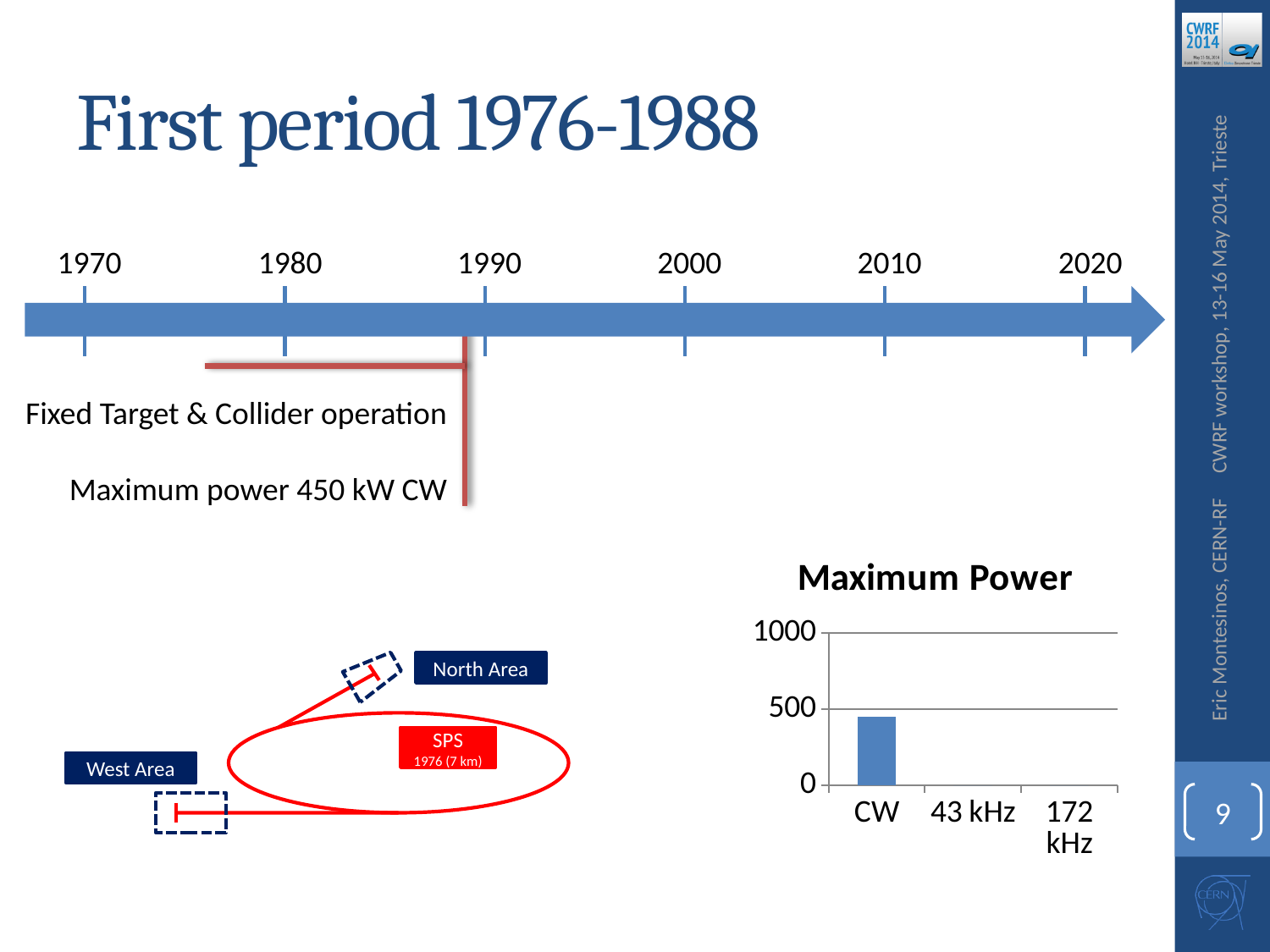
In the Maximum Power chart, which is larger, the value for CW or the value for 43 kHz? CW In the Maximum Power chart, which is larger, the value for CW or the value for 172 kHz? CW What kind of chart is the Maximum Power chart? bar chart How many categories are shown on the x axis of the Maximum Power chart? 3 What is the highest tick value shown on the y axis of the Maximum Power chart? 1000 What is the title of the chart on the slide? Maximum Power In the Maximum Power chart, is the value for CW greater or less than 500? less What is the label of the third category on the x axis of the Maximum Power chart? 172 kHz In the Maximum Power chart, is the value for CW greater or less than 1000? less Which category has the highest value in the Maximum Power chart? CW